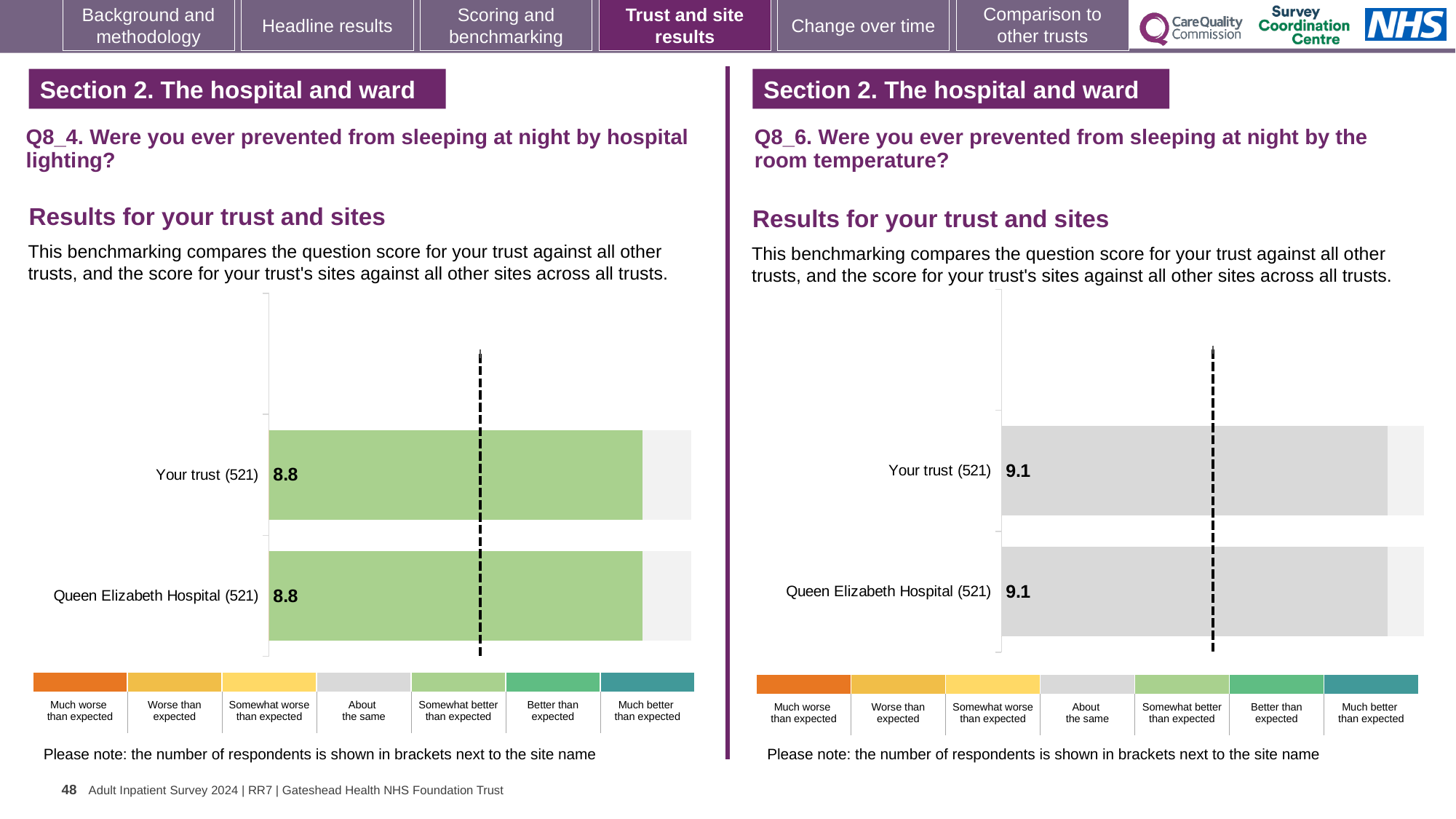
In the Q8_4 chart about hospital lighting, what is the score for Queen Elizabeth Hospital? 8.8 In the Q8_6 chart about room temperature, what is the score for Your trust? 9.1 What kind of chart is used for the Q8_4 results about hospital lighting? Bar chart In the Q8_4 chart about hospital lighting, what is the difference between the score for Your trust and the score for Queen Elizabeth Hospital? 0.0 In the Q8_6 chart about room temperature, what is the difference between the score for Your trust and the score for Queen Elizabeth Hospital? 0.0 In the Q8_4 chart about hospital lighting, what is the score for Your trust? 8.8 How many respondents are shown in brackets for Your trust in the Q8_6 chart about room temperature? 521 In the Q8_6 chart about room temperature, what is the score for Queen Elizabeth Hospital? 9.1 How many bars are plotted in the Q8_4 chart about hospital lighting? 2 How many bars are plotted in the Q8_6 chart about room temperature? 2 In the Q8_6 chart about room temperature, which benchmark category does the grey colour of the bars correspond to? About the same In the Q8_4 chart about hospital lighting, which benchmark category does the green colour of the bars correspond to? Somewhat better than expected